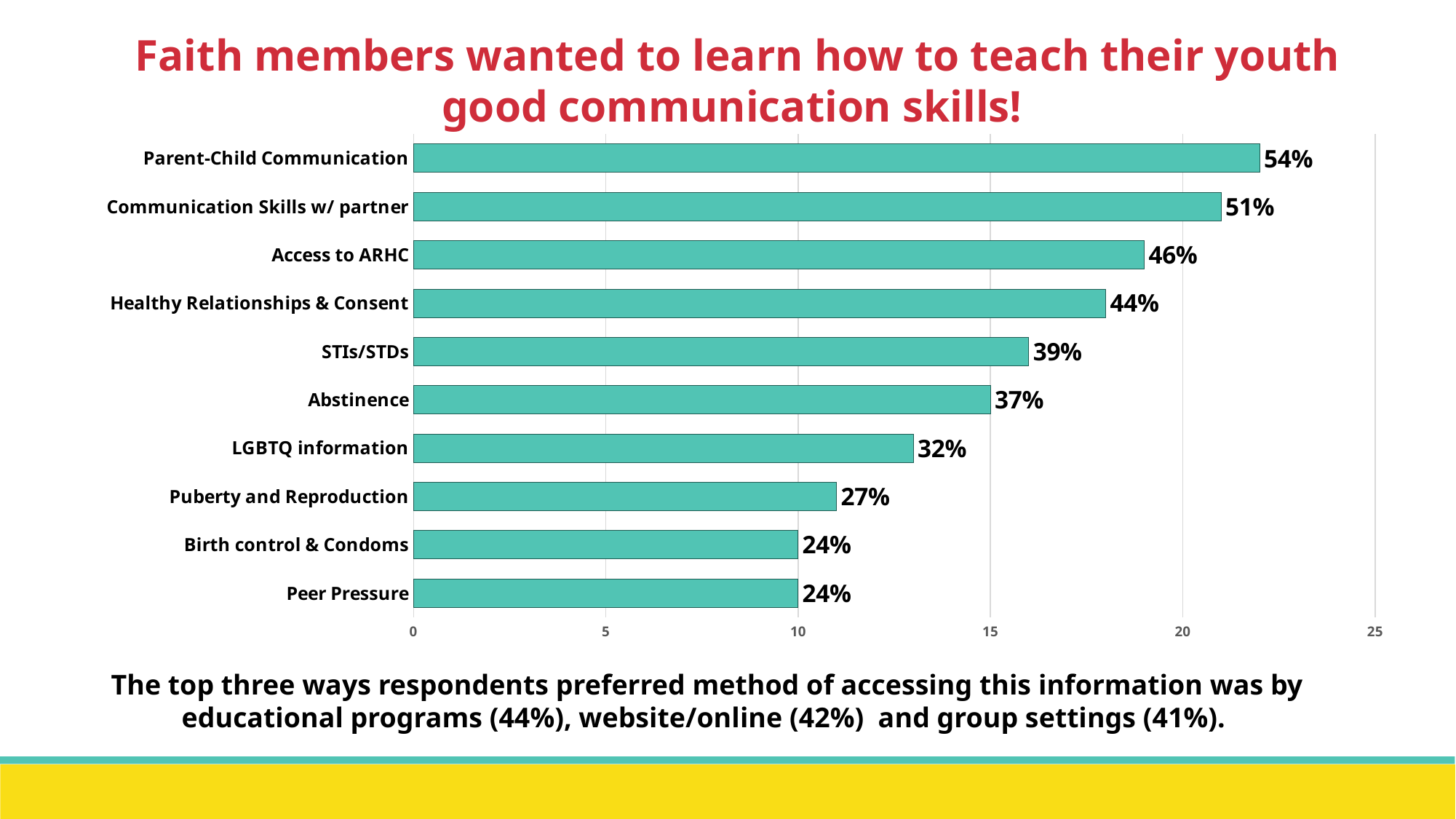
What is the difference in percentage points between Parent-Child Communication and Communication Skills w/ partner? 3 What kind of chart is shown on the slide? Bar chart Which category has the highest value? Parent-Child Communication How many categories are shown on the chart? 10 What is the data label for Access to ARHC? 46% Is the bar for Parent-Child Communication greater or less than 20 on the axis? greater What is the data label for Puberty and Reproduction? 27% What is the lowest data label shown on the chart? 24% What is the data label for LGBTQ information? 32% What is the title of the slide? Faith members wanted to learn how to teach their youth good communication skills! What is the data label for Parent-Child Communication? 54% Which is larger, the value for STIs/STDs or the value for Abstinence? STIs/STDs